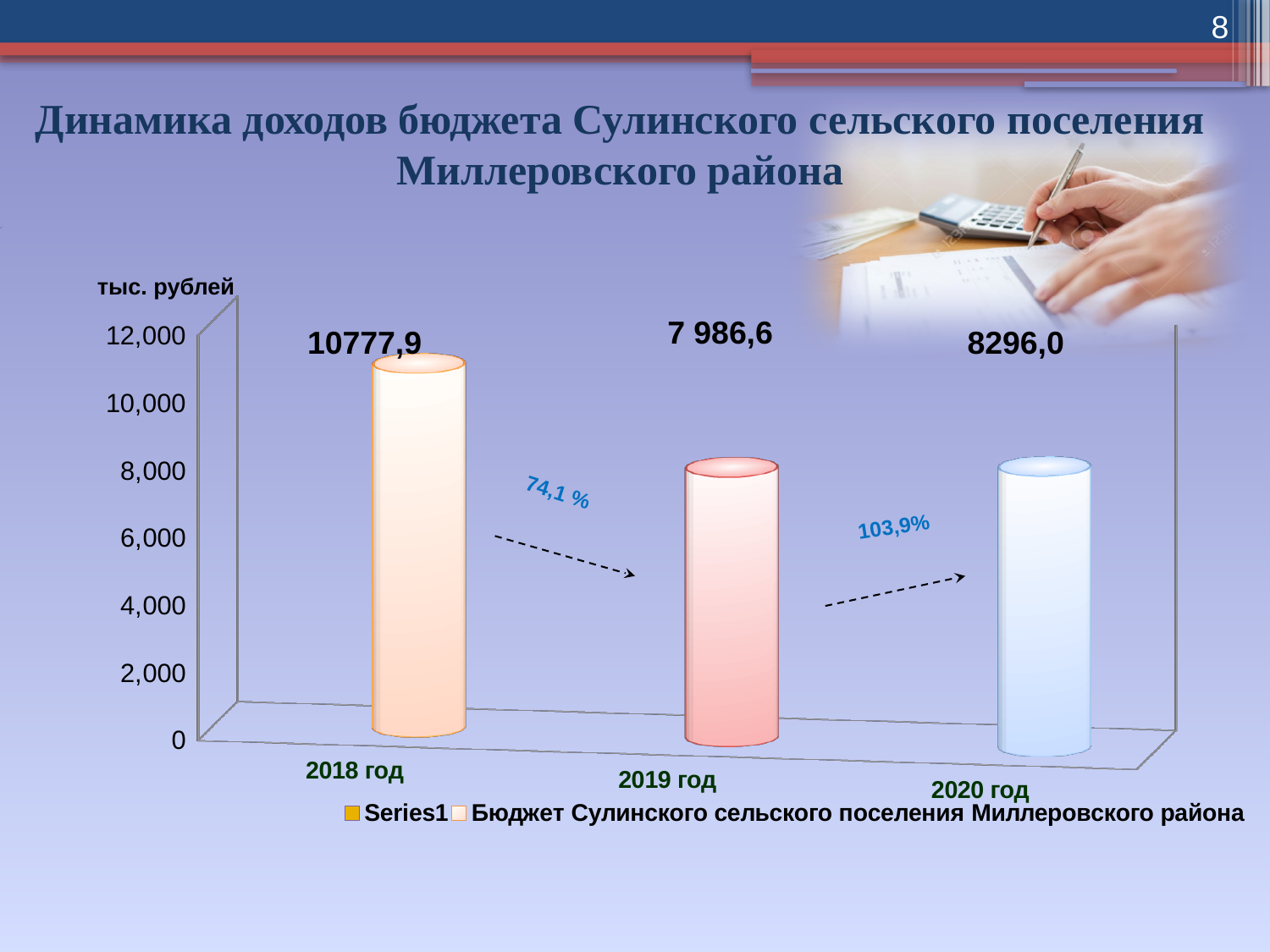
What kind of chart is shown on the slide? bar chart What is the difference between the values for 2020 год and 2019 год? 309,4 What is the value for 2018 год? 10777,9 What unit is shown on the vertical axis of the chart? тыс. рублей Is the value for 2018 год greater or less than 10,000? greater Which year has the highest value? 2018 год What is the value for 2020 год? 8296,0 Which year has the lowest value? 2019 год How many years are shown on the x axis? 3 What is the difference between the values for 2018 год and 2019 год? 2791,3 What is the value for 2019 год? 7 986,6 Which is larger, the value for 2019 год or the value for 2020 год? 2020 год